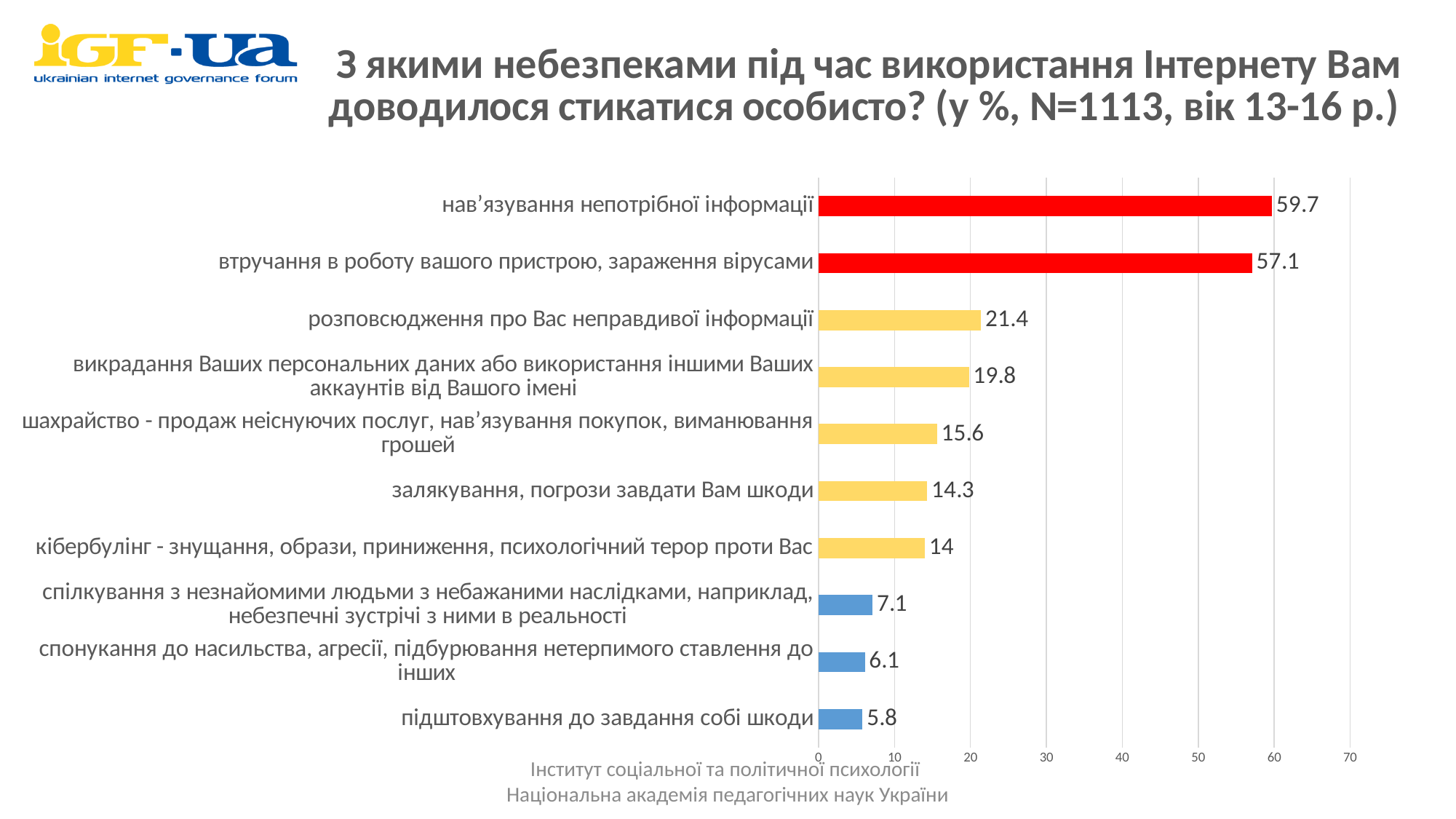
Which category has the highest value? нав’язування непотрібної інформації What value is shown for "залякування, погрози завдати Вам шкоди"? 14.3 How many categories are shown in the chart? 10 Which category has the lowest value? підштовхування до завдання собі шкоди What value is shown for "втручання в роботу вашого пристрою, зараження вірусами"? 57.1 What is the difference between the values for "розповсюдження про Вас неправдивої інформації" and "викрадання Ваших персональних даних або використання іншими Ваших аккаунтів від Вашого імені"? 1.6 What kind of chart is shown on the slide? bar chart Which is larger: the value for "шахрайство - продаж неіснуючих послуг, нав’язування покупок, виманювання грошей" or the value for "спілкування з незнайомими людьми з небажаними наслідками, наприклад, небезпечні зустрічі з ними в реальності"? шахрайство - продаж неіснуючих послуг, нав’язування покупок, виманювання грошей What value is shown for "нав’язування непотрібної інформації"? 59.7 What is the difference between the values for "нав’язування непотрібної інформації" and "втручання в роботу вашого пристрою, зараження вірусами"? 2.6 What colour are the two bars with the highest values? red What value is shown for "підштовхування до завдання собі шкоди"? 5.8